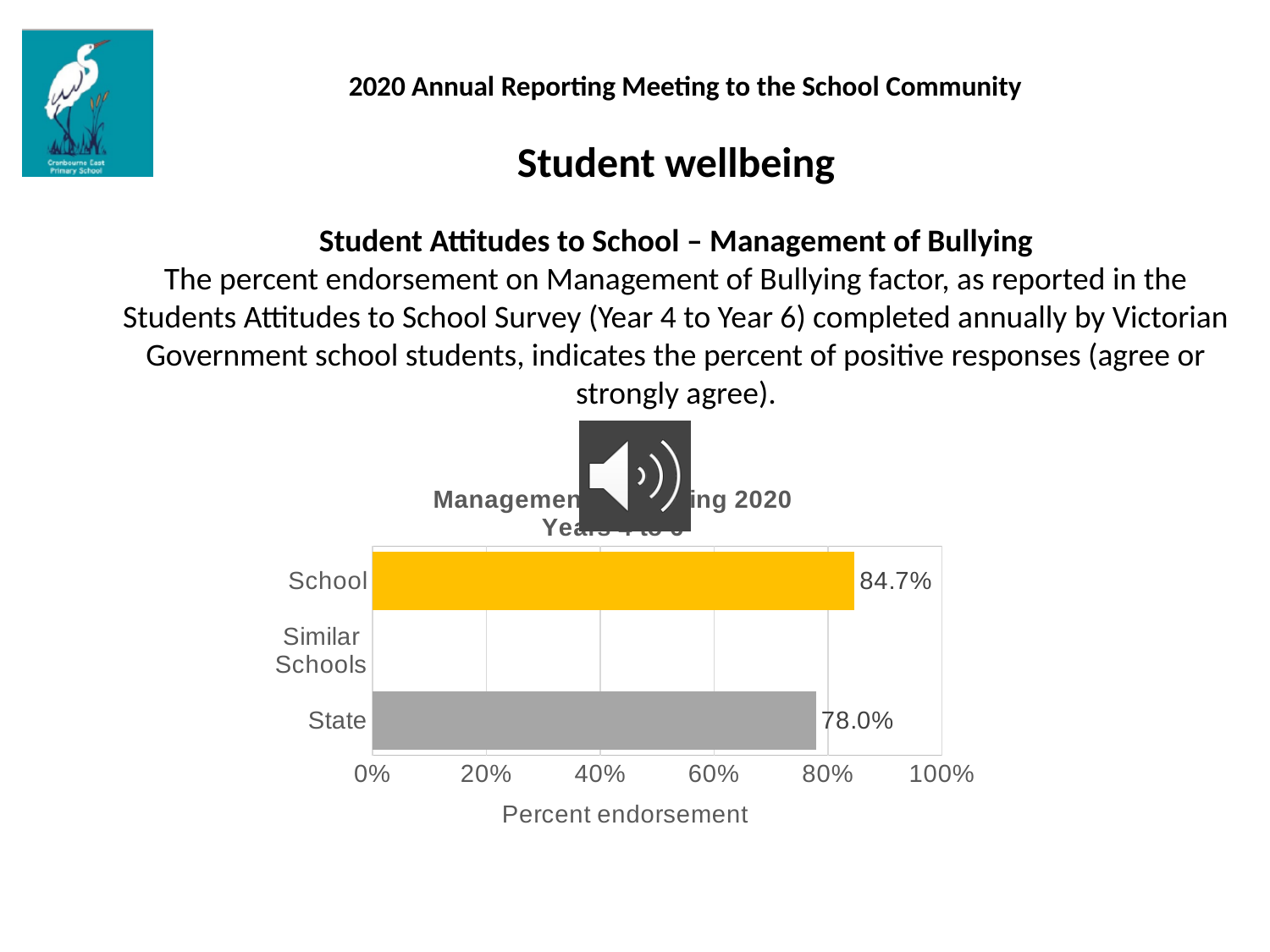
What kind of chart is shown on the slide? Bar chart Which is larger, the percent endorsement for School or for State? School Is the value for School greater or less than 80%? greater Which category on the chart has no bar plotted? Similar Schools What is the difference between the School and State percent endorsement values? 6.7 percentage points What is the percent endorsement for State? 78.0% Which category has the highest percent endorsement? School Is the value for State greater or less than 80%? less What is the label on the horizontal axis of the chart? Percent endorsement How many categories are listed on the vertical axis of the chart? 3 What is the percent endorsement for School? 84.7%